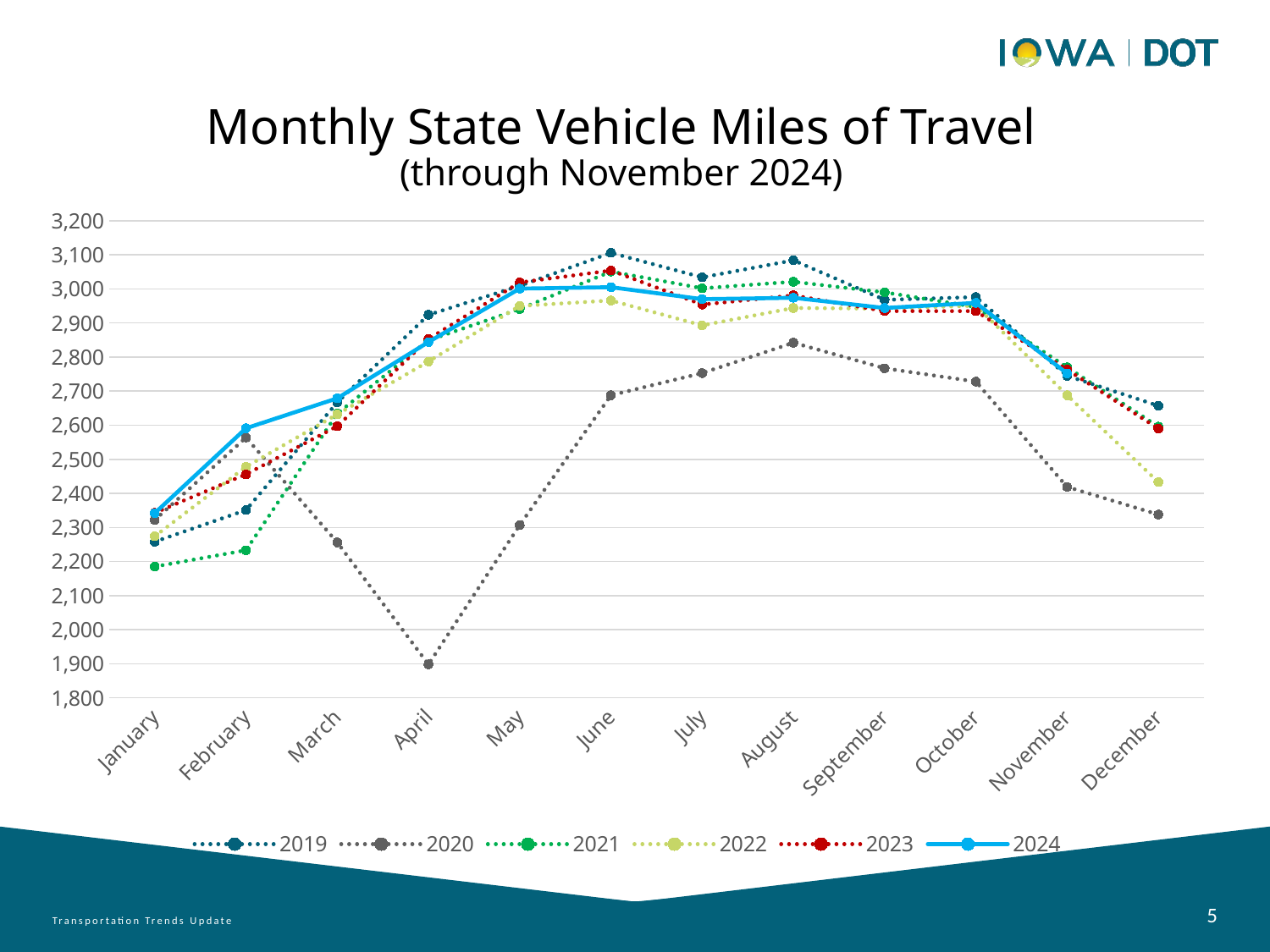
What kind of chart is shown on the slide? line chart In which month does the 2020 series reach its highest value? August Is the value for 2020 in December greater or less than 2,400? less How many months are shown along the x axis? 12 Is the value for 2024 in November greater or less than 2,700? greater Is the value for 2021 in January greater or less than 2,300? less How many series does the legend list? 6 In which month does the 2020 series reach its lowest value? April In August, which is larger: the value for 2019 or the value for 2020? 2019 Which series has the lowest value in April? 2020